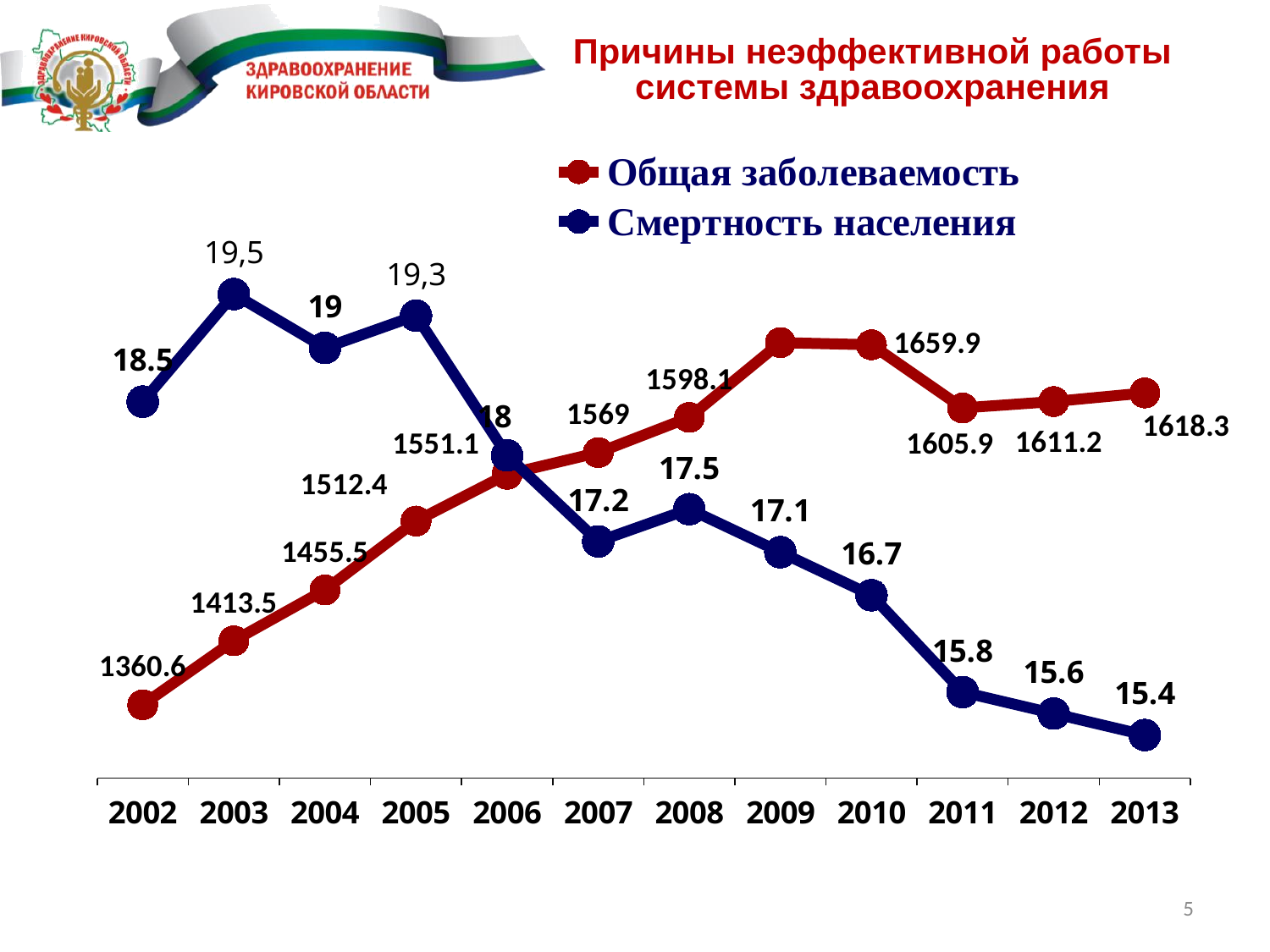
How many years are shown on the x axis? 12 In which year is Смертность населения lowest? 2013 What type of chart is shown on the slide? line chart What is the value of Смертность населения in 2003? 19,5 How many series does the legend list? 2 What is the value of Общая заболеваемость in 2007? 1569 In which year is Смертность населения highest? 2003 What is the value of Смертность населения in 2013? 15.4 What is the value of Общая заболеваемость in 2002? 1360.6 Does Смертность населения rise or fall from 2005 to 2013? fall In which year is Общая заболеваемость lowest? 2002 What is the difference between Общая заболеваемость in 2013 and in 2011? 12.4